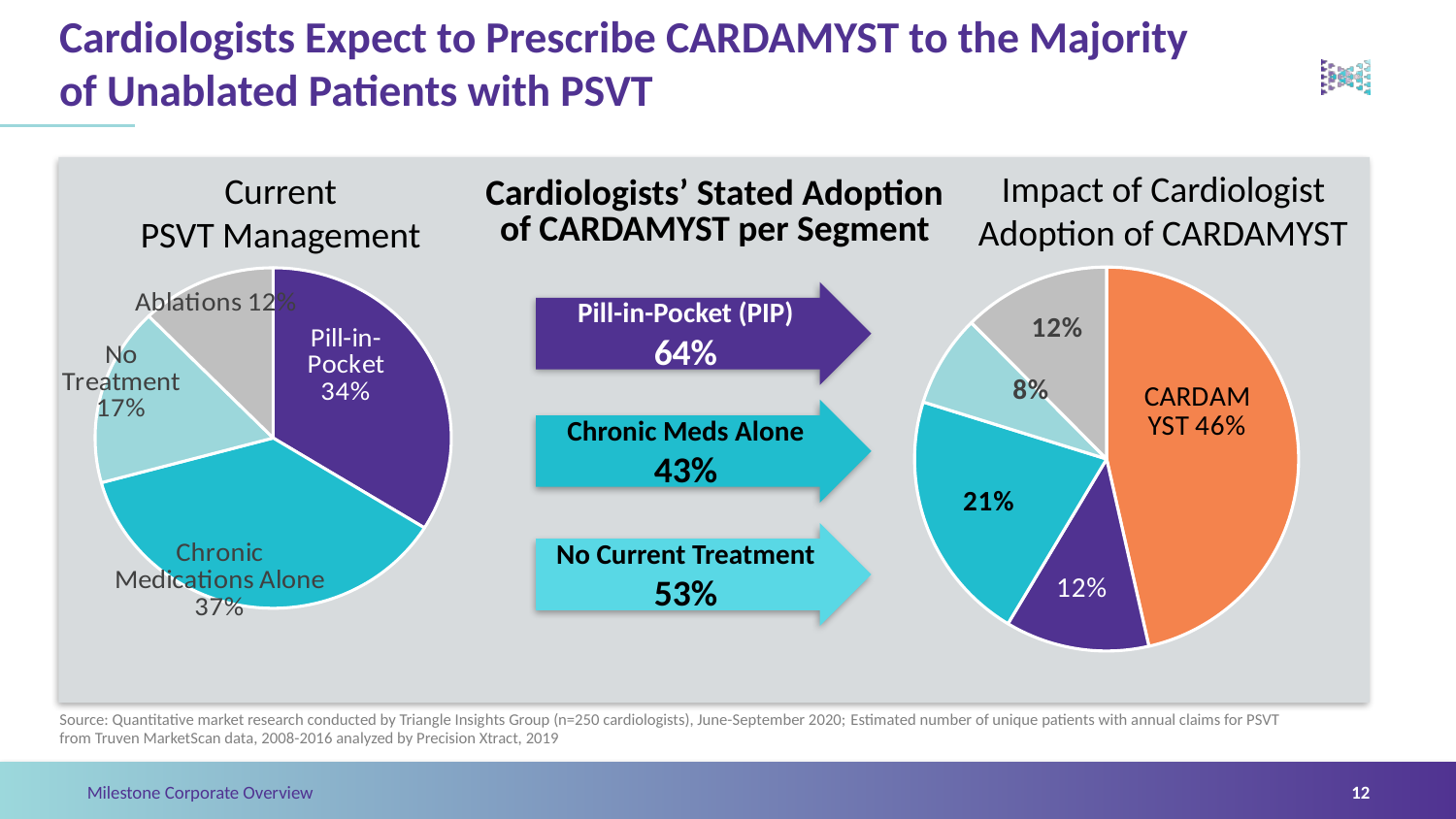
In the Impact of Cardiologist Adoption of CARDAMYST pie chart, which slice is the largest? CARDAMYST In the Current PSVT Management pie chart, how many slices are there? 4 In the Current PSVT Management pie chart, which category has the largest share? Chronic Medications Alone In the Current PSVT Management pie chart, what share is Ablations? 12% What type of chart is the Current PSVT Management chart? Pie chart In the Current PSVT Management pie chart, which category has the smallest share? Ablations In the Current PSVT Management pie chart, what share is Chronic Medications Alone? 37% In the Current PSVT Management pie chart, what share is No Treatment? 17% In the Current PSVT Management pie chart, what share is Pill-in-Pocket? 34% In the Current PSVT Management pie chart, what is the difference between the Chronic Medications Alone share and the No Treatment share? 20% In the Impact of Cardiologist Adoption of CARDAMYST pie chart, how many slices are there? 5 In the Impact of Cardiologist Adoption of CARDAMYST pie chart, what share is CARDAMYST? 46%